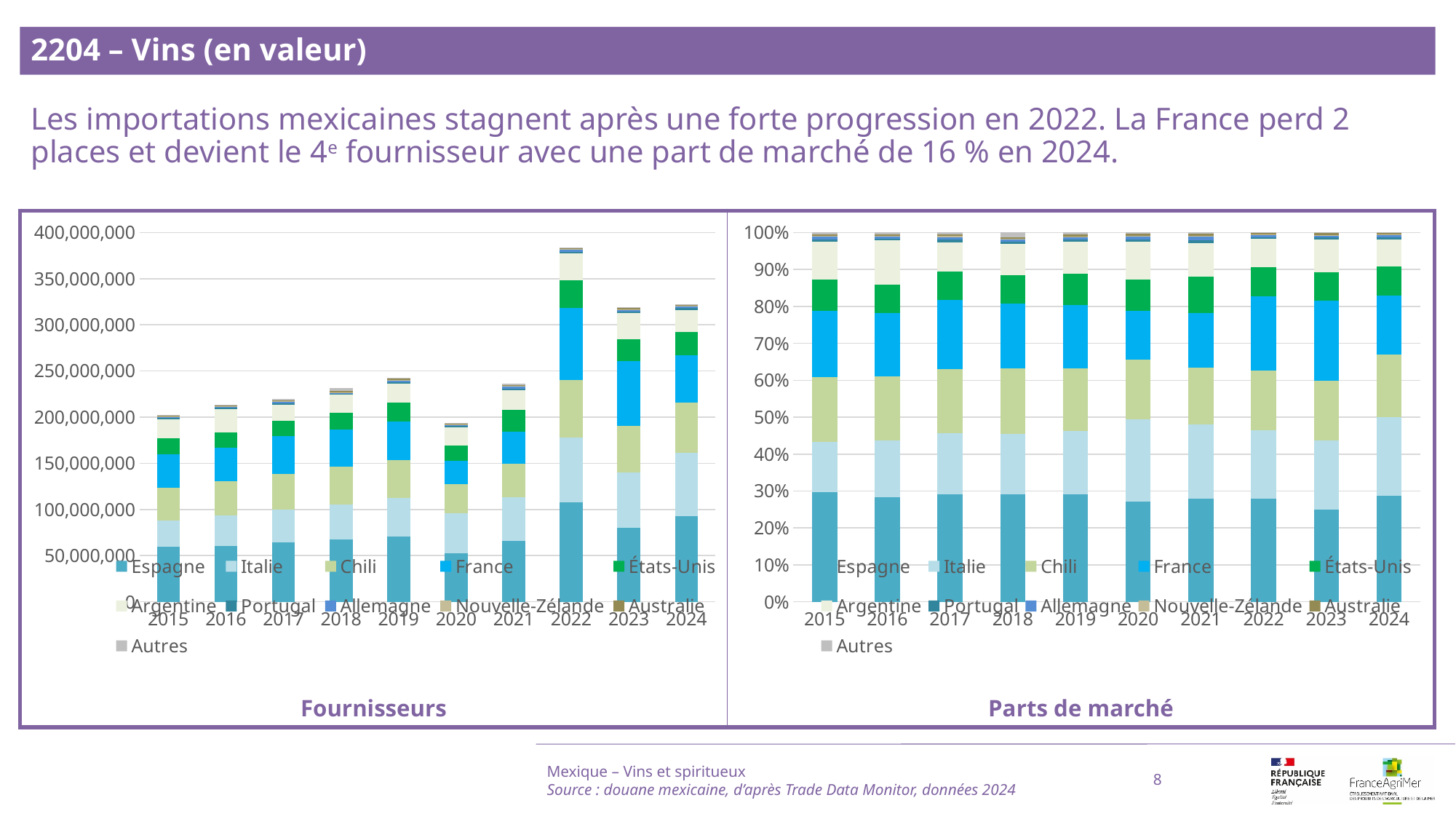
What kind of chart is the 'Fournisseurs' chart on the left? stacked bar chart In the 'Fournisseurs' chart, which year has the lowest total bar? 2020 In the 'Fournisseurs' chart, which year has the highest total bar? 2022 How many series does the legend of the 'Parts de marché' chart list? 11 In the 'Fournisseurs' chart, do the total bars rise or fall from 2015 to 2019? rise In the 'Fournisseurs' chart, is the total for 2015 greater or less than 250,000,000? less How many years are shown on the x axis of the 'Fournisseurs' chart? 10 Which series is listed first in the legend of the 'Fournisseurs' chart? Espagne In the 'Fournisseurs' chart, is the total for 2022 greater or less than 350,000,000? greater In the 'Parts de marché' chart, is the share for Espagne in 2015 greater or less than 20%? greater In the 'Fournisseurs' chart, which year has the larger total bar, 2022 or 2023? 2022